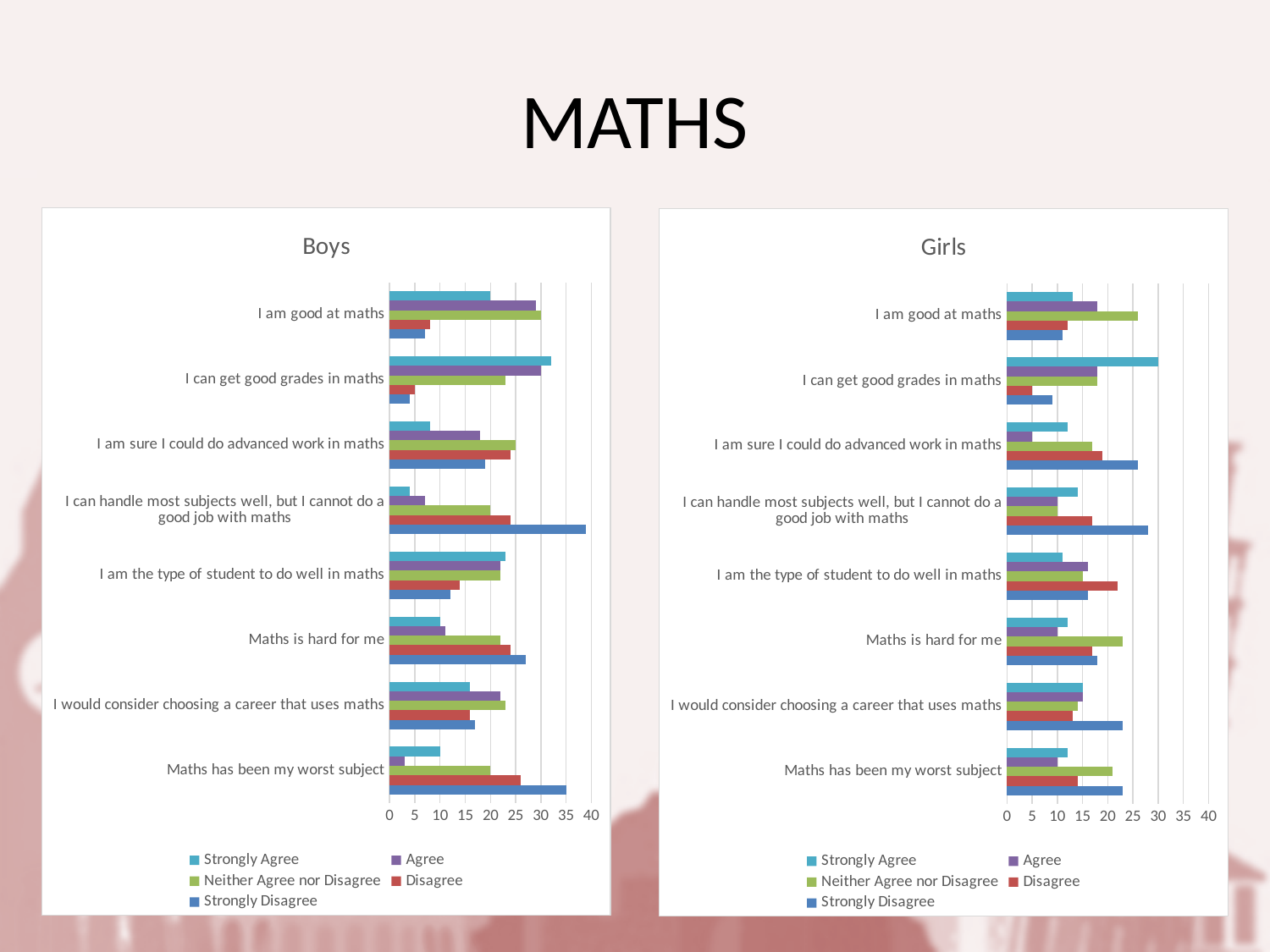
In the Boys chart, is the Strongly Disagree value for "I can handle most subjects well, but I cannot do a good job with maths" greater or less than 35? greater In the Girls chart, for "Maths is hard for me", which is larger: Neither Agree nor Disagree or Agree? Neither Agree nor Disagree In the Boys chart, is the Strongly Agree value for "I can get good grades in maths" greater or less than 30? greater How many series does the legend of the Girls chart list? 5 In the Girls chart, which statement has the highest Strongly Agree value? I can get good grades in maths How many statements (categories) are shown on the Boys chart? 8 What kind of chart is the Boys chart? bar chart In the Girls chart, is the Strongly Disagree value for "I can handle most subjects well, but I cannot do a good job with maths" greater or less than 25? greater In the Boys chart, for "I can get good grades in maths", which is larger: Strongly Agree or Strongly Disagree? Strongly Agree What are the titles of the two charts on the slide? Boys and Girls